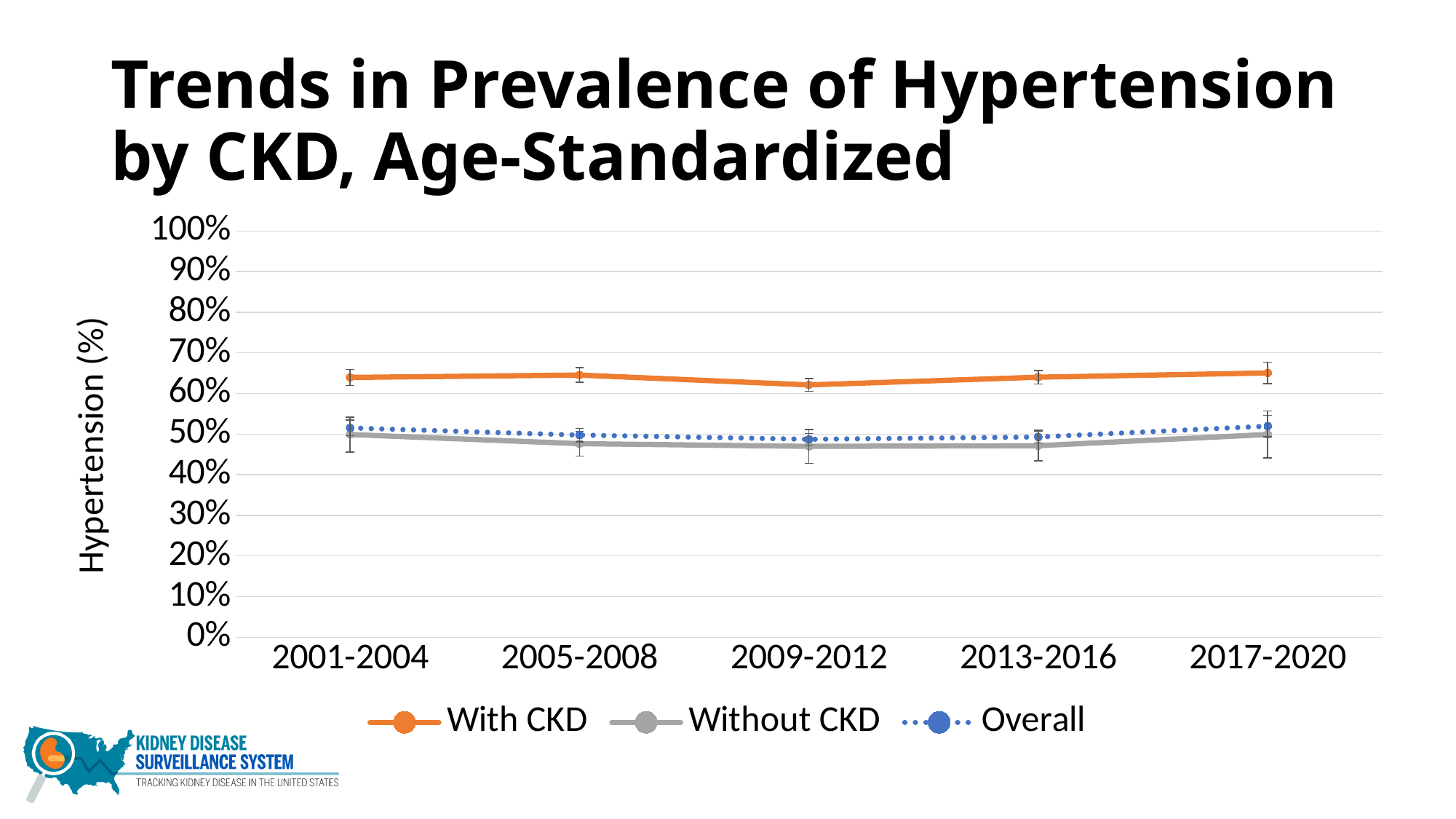
Is the value for With CKD in 2009-2012 greater or less than 70%? less In 2013-2016, which is larger: the value for With CKD or the value for Without CKD? With CKD How many series does the legend list? 3 Is the value for With CKD in 2001-2004 greater or less than 60%? greater Which series has the highest hypertension prevalence across all periods? With CKD What kind of chart is shown on the slide? line chart Is the value for Without CKD in 2005-2008 greater or less than 50%? less How many time periods are plotted along the x axis? 5 Does the With CKD line rise sharply, fall sharply, or stay roughly flat from 2001-2004 to 2017-2020? roughly flat What is the label on the y axis? Hypertension (%) Which series has the lowest hypertension prevalence across all periods? Without CKD